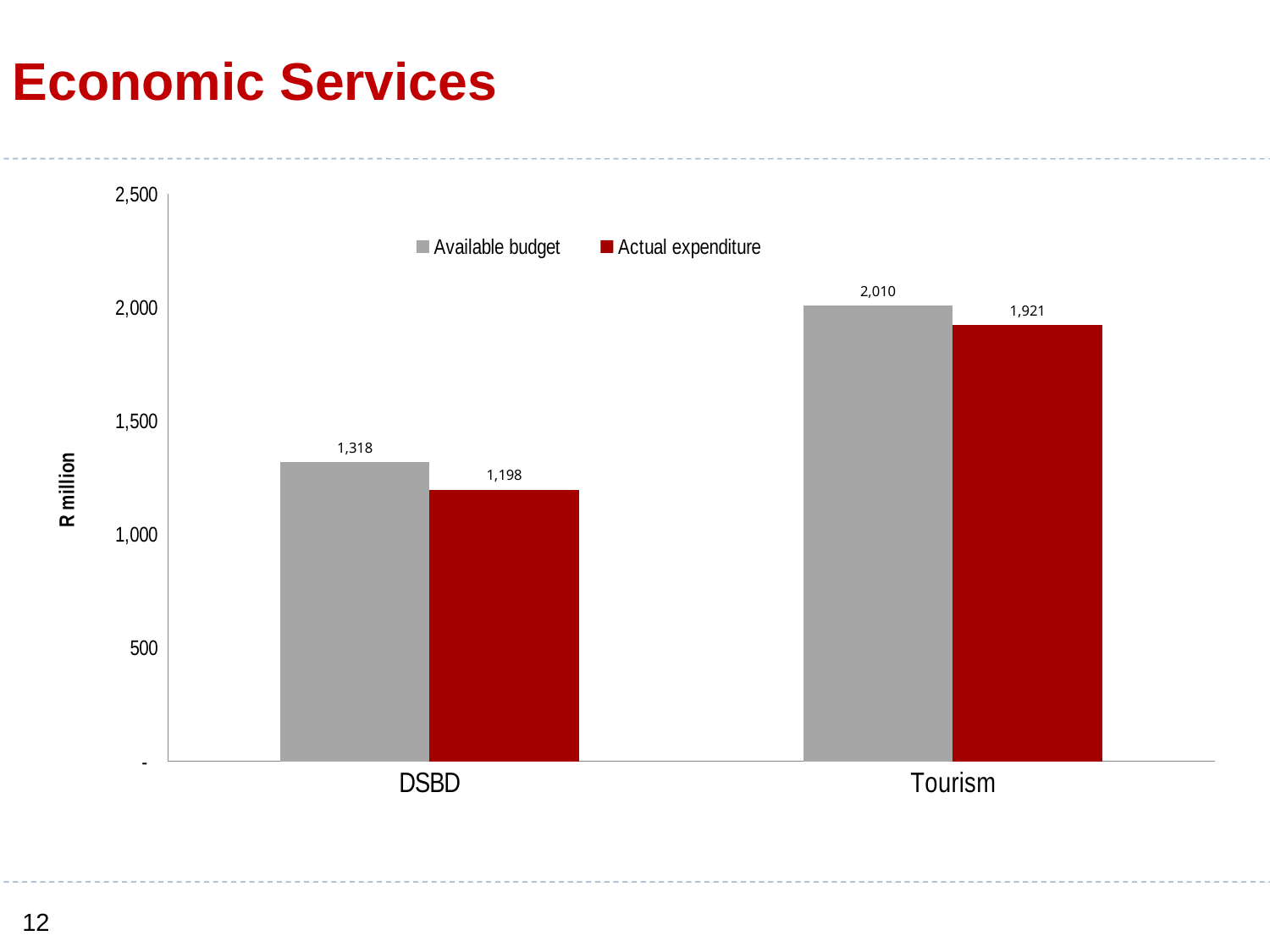
Which category has the lowest Actual expenditure? DSBD How many categories are shown on the x axis? 2 How many series does the legend list? 2 What is the Actual expenditure for Tourism? 1,921 Is the Available budget for Tourism greater or less than 2,000? greater What is the difference between the Available budget and Actual expenditure for DSBD? 120 What is the Actual expenditure for DSBD? 1,198 What kind of chart is shown on the slide? Bar chart What is the difference between the Available budget and Actual expenditure for Tourism? 89 What is the Available budget for DSBD? 1,318 Which category has the highest Available budget? Tourism Which is larger, the Available budget for DSBD or the Actual expenditure for Tourism? Actual expenditure for Tourism